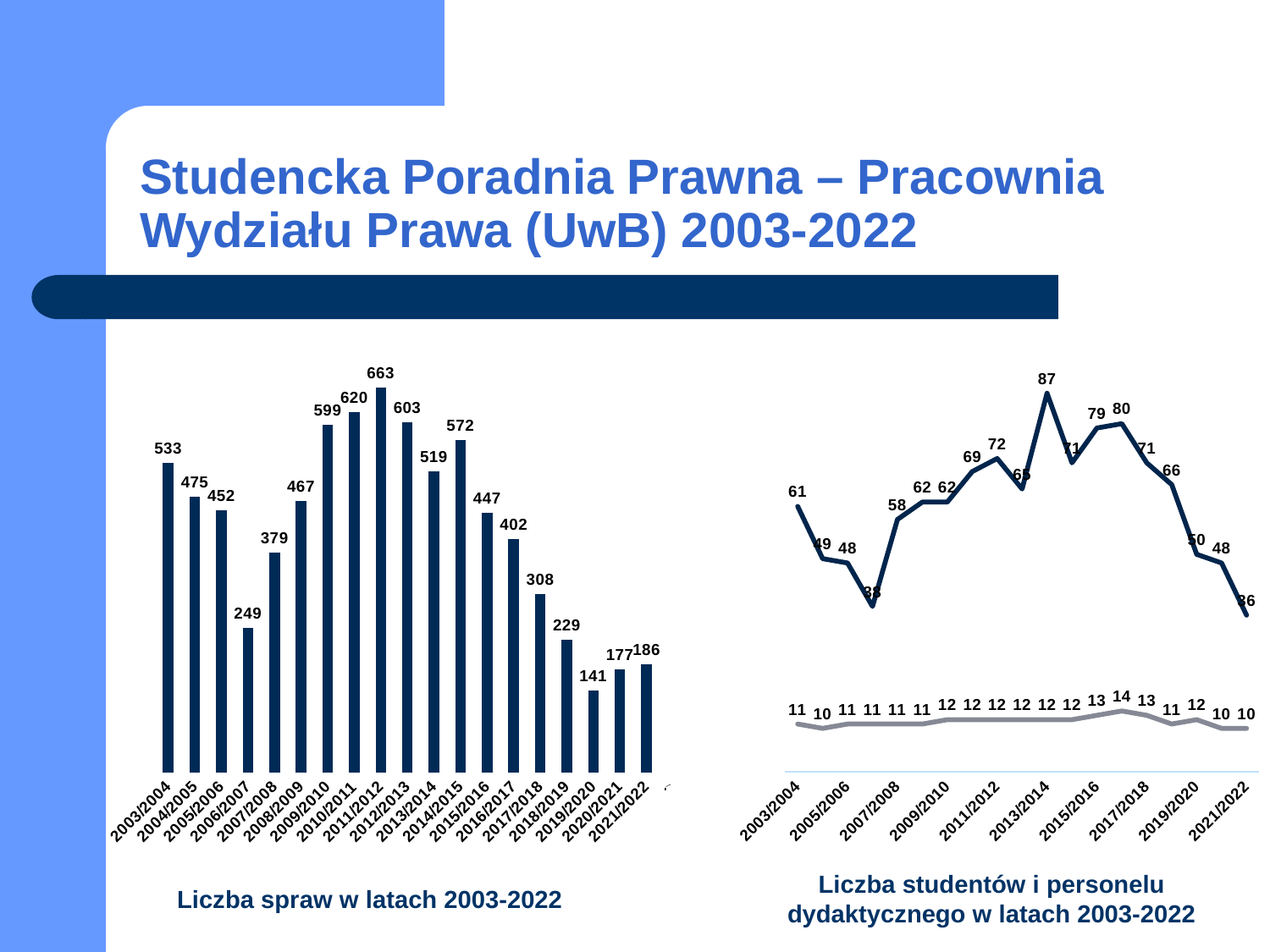
In the chart 'Liczba spraw w latach 2003-2022', what is the value for 2006/2007? 249 What kind of chart is 'Liczba studentów i personelu dydaktycznego w latach 2003-2022'? line chart In the chart 'Liczba spraw w latach 2003-2022', what is the value for 2011/2012? 663 In the chart 'Liczba spraw w latach 2003-2022', which year has the highest value? 2011/2012 What kind of chart is 'Liczba spraw w latach 2003-2022'? bar chart In the chart 'Liczba spraw w latach 2003-2022', which is larger, the value for 2014/2015 or the value for 2013/2014? 2014/2015 In the chart 'Liczba studentów i personelu dydaktycznego w latach 2003-2022', what is the value of the upper line for 2003/2004? 61 In the chart 'Liczba spraw w latach 2003-2022', do the values rise or fall from 2014/2015 to 2019/2020? fall In the chart 'Liczba spraw w latach 2003-2022', which year has the lowest value? 2019/2020 In the chart 'Liczba spraw w latach 2003-2022', what is the difference between the values for 2003/2004 and 2004/2005? 58 How many bars are in the chart 'Liczba spraw w latach 2003-2022'? 19 In the chart 'Liczba studentów i personelu dydaktycznego w latach 2003-2022', what is the highest value on the upper line? 87